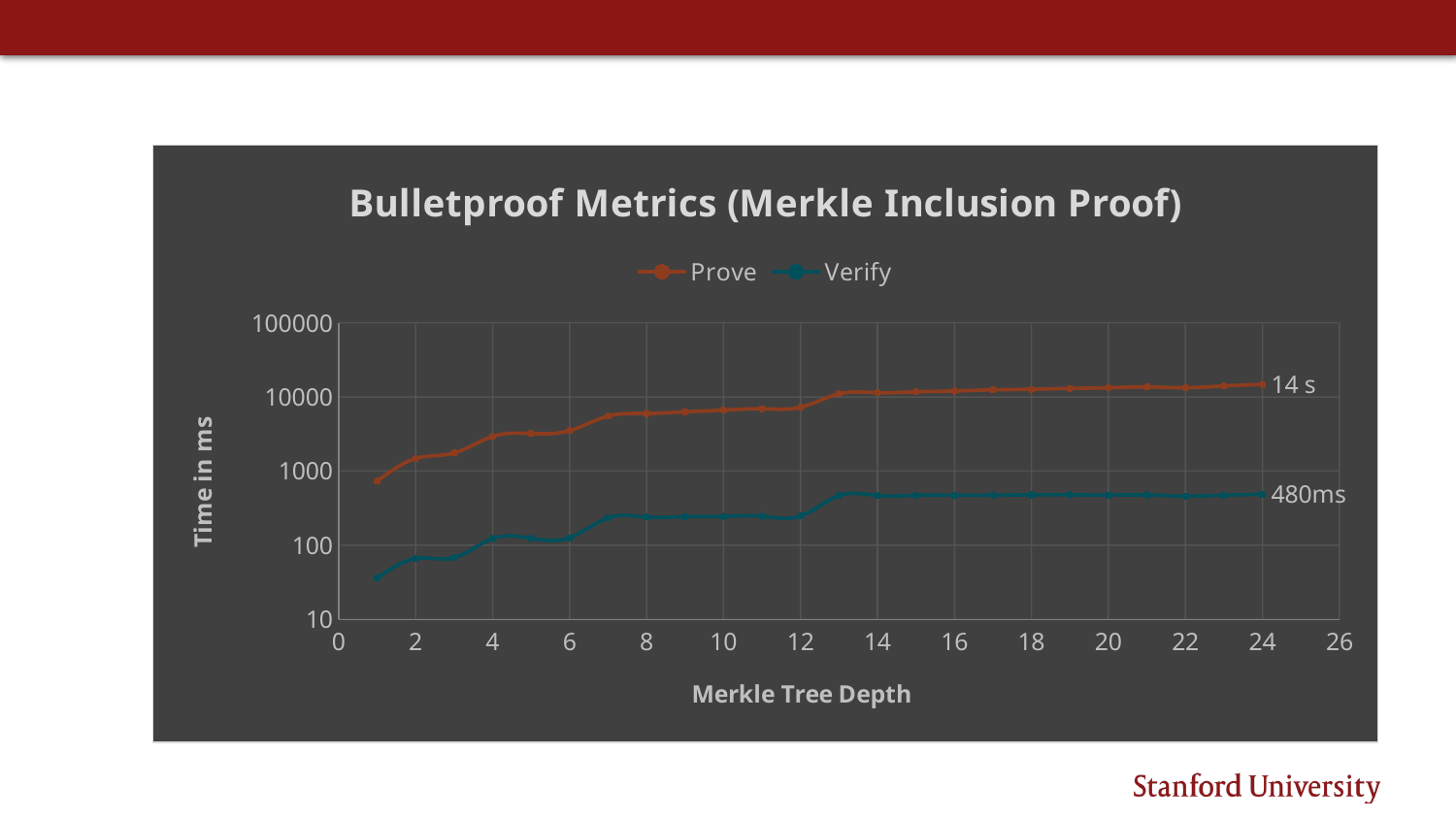
What is the title of the chart? Bulletproof Metrics (Merkle Inclusion Proof) What value is annotated at the end of the Verify line? 480ms Do the Prove times rise or fall as Merkle tree depth increases? rise What value is annotated at the end of the Prove line? 14 s Which series has higher values across all Merkle tree depths, Prove or Verify? Prove Is the Prove value at depth 1 greater or less than 1000? less Is the Verify value at depth 1 greater or less than 100? less What is the label of the x axis? Merkle Tree Depth How many series does the legend list? 2 What type of chart is shown on the slide? line chart Is the Verify value at depth 20 greater or less than 1000? less